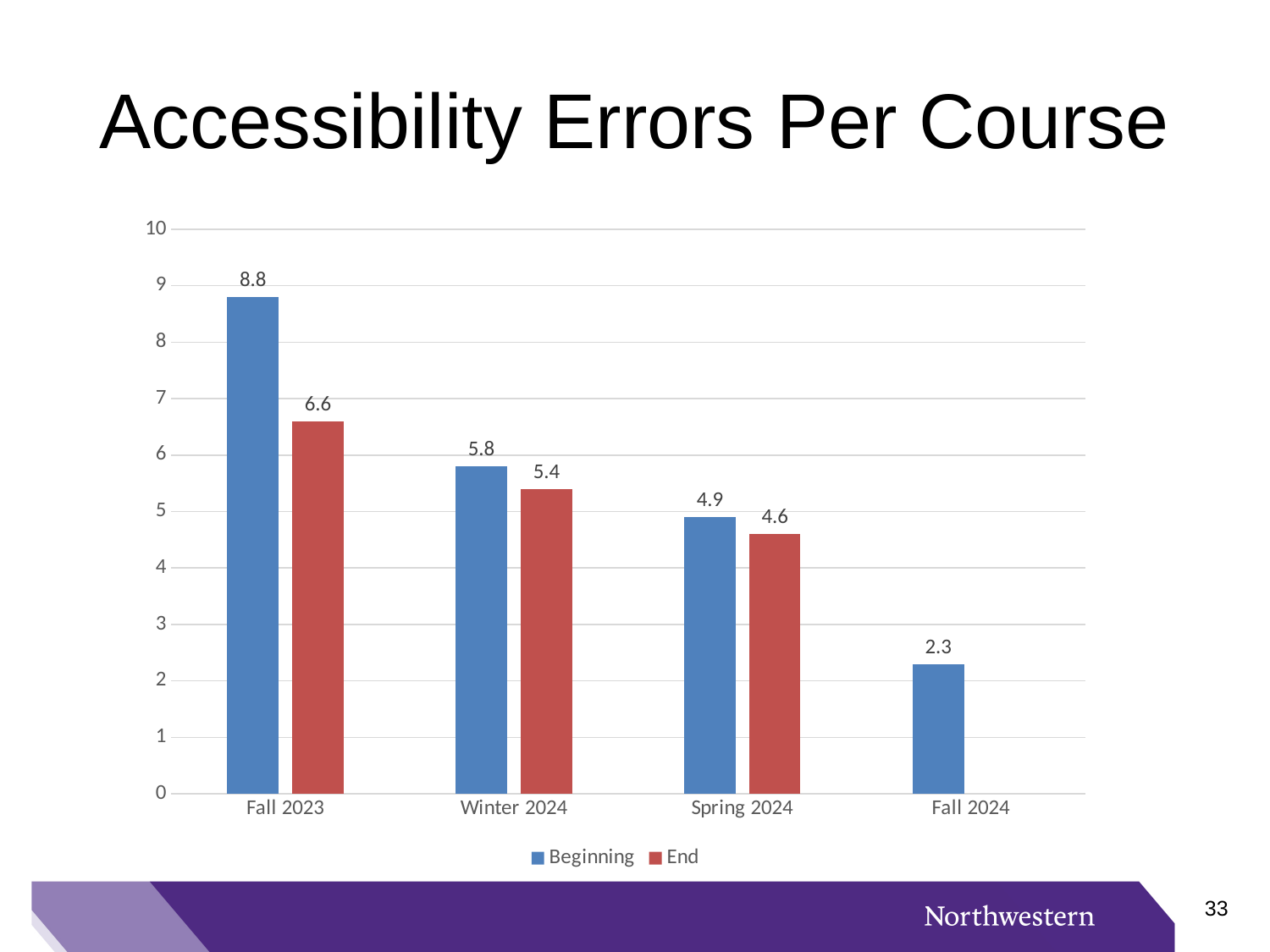
What is the Beginning value for Fall 2023? 8.8 Which is larger, the End value for Winter 2024 or the Beginning value for Spring 2024? End value for Winter 2024 What is the title of the chart? Accessibility Errors Per Course What is the difference between the Beginning and End values for Fall 2023? 2.2 What is the End value for Winter 2024? 5.4 How many series does the legend list? 2 How many terms are shown on the x axis? 4 Which term has the lowest End value? Spring 2024 Which term has the highest Beginning value? Fall 2023 What is the Beginning value for Fall 2024? 2.3 What kind of chart is shown? Bar chart Do the Beginning values rise or fall from Fall 2023 to Fall 2024? Fall